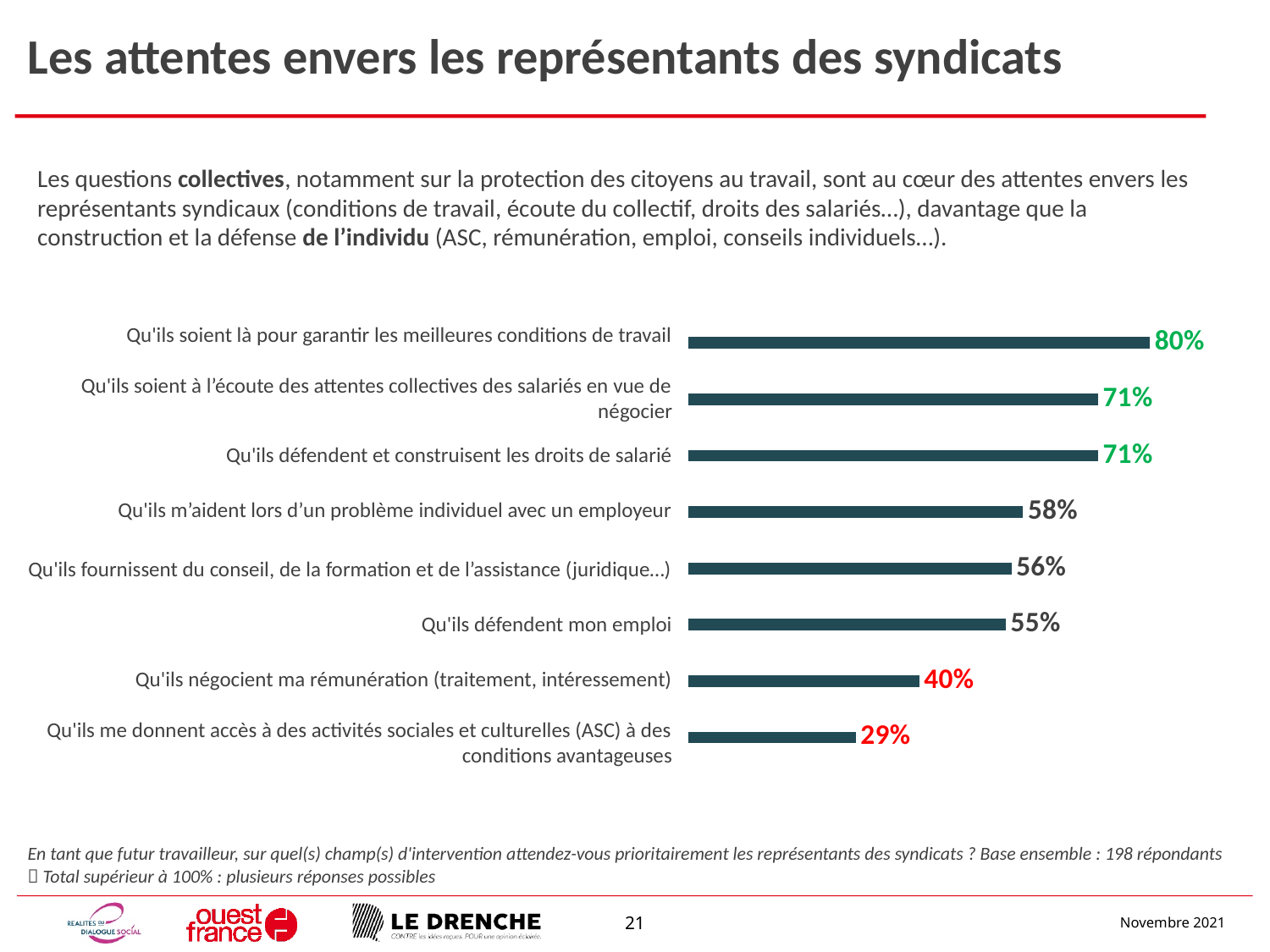
What is the difference between the highest value (80%) and the lowest value (29%)? 51 percentage points Which is larger: the value for "Qu'ils défendent mon emploi" or the value for "Qu'ils négocient ma rémunération (traitement, intéressement)"? Qu'ils défendent mon emploi Do the values rise or fall going from the top bar to the bottom bar? Fall Which category has the lowest value? Qu'ils me donnent accès à des activités sociales et culturelles (ASC) à des conditions avantageuses What is the difference between "Qu'ils m'aident lors d'un problème individuel avec un employeur" and "Qu'ils fournissent du conseil, de la formation et de l'assistance (juridique…)"? 2 percentage points How many categories are shown in the chart? 8 What is the value for "Qu'ils soient là pour garantir les meilleures conditions de travail"? 80% Which category has the highest value? Qu'ils soient là pour garantir les meilleures conditions de travail What colour are the data labels for the two lowest values (40% and 29%)? Red What is the value for "Qu'ils défendent mon emploi"? 55% What is the value for "Qu'ils négocient ma rémunération (traitement, intéressement)"? 40% What kind of chart is shown on the slide? Bar chart